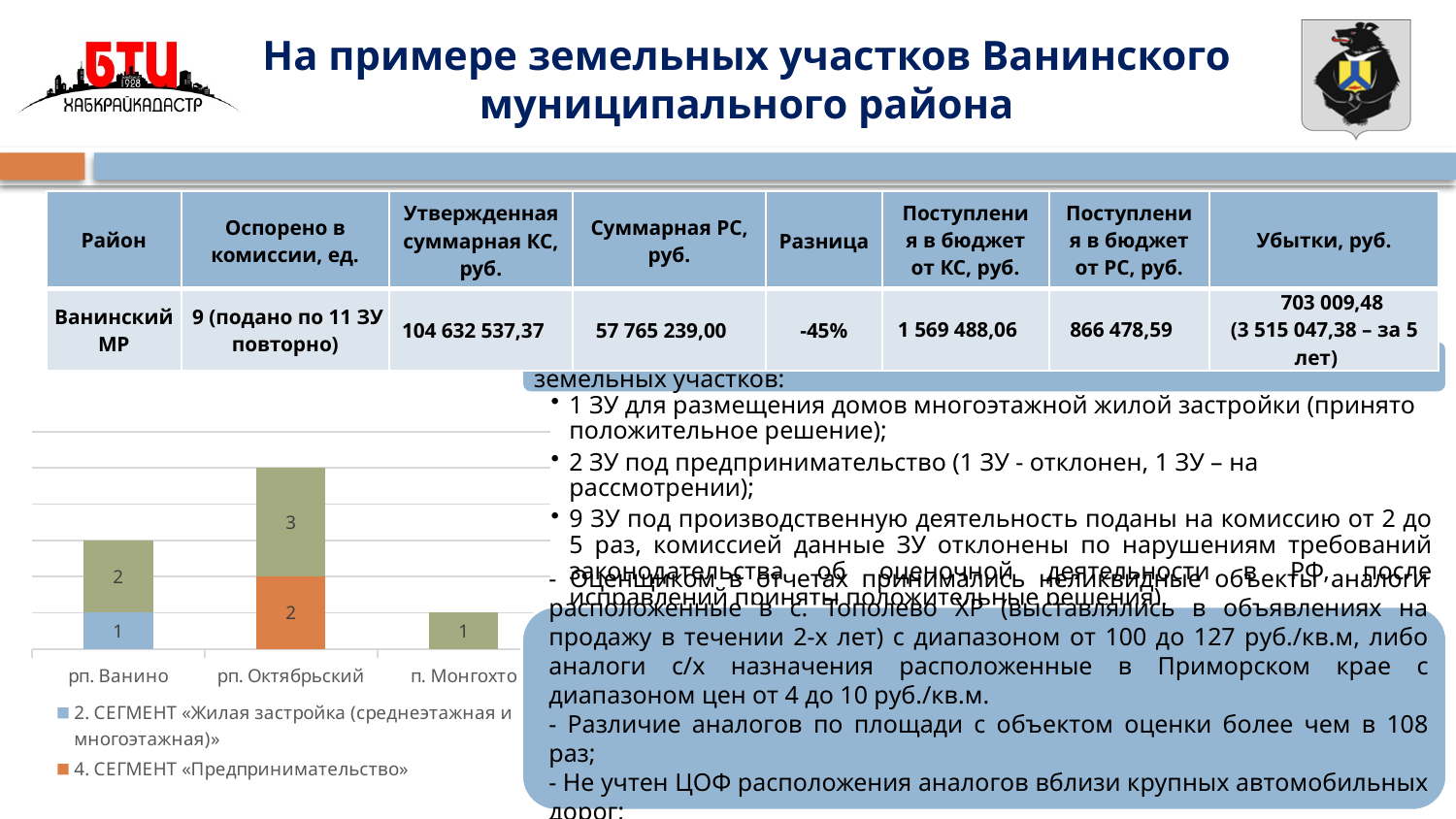
Which settlement has the shortest stacked bar? п. Монгохто What is the value of the «Жилая застройка (среднеэтажная и многоэтажная)» segment for рп. Ванино? 1 What is the total of the stacked bar for рп. Ванино? 3 What is the value of the «Предпринимательство» segment for рп. Октябрьский? 2 What is the total of the stacked bar for рп. Октябрьский? 5 How many categories (settlements) are shown on the x axis of the chart? 3 Which is larger: the total bar for рп. Ванино or the total bar for п. Монгохто? рп. Ванино What colour is the «Предпринимательство» segment in the chart? orange What is the difference between the total for рп. Октябрьский and the total for рп. Ванино? 2 What type of chart is shown on the slide? stacked bar chart What is the value of the single segment shown for п. Монгохто? 1 Which settlement has the tallest stacked bar? рп. Октябрьский